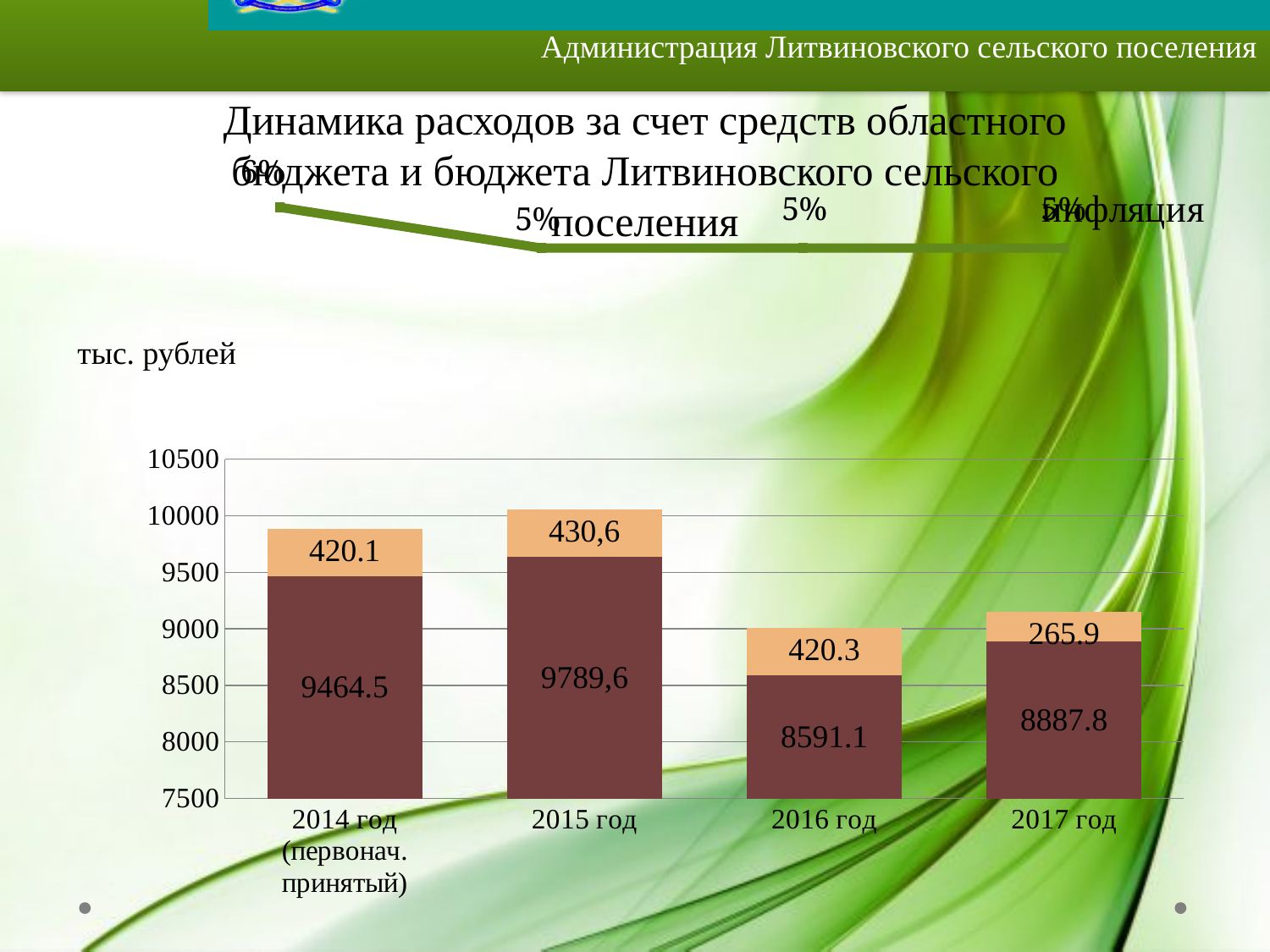
What is the value of the upper (orange) segment of the bar for 2017 год? 265.9 What is the total of the stacked bar for 2014 год (первонач. принятый)? 9884.6 What type of chart is used to show the expenditure values? bar chart What is the difference between the lower segment values for 2014 год (первонач. принятый) and 2016 год? 873.4 Which year has the lowest value in the lower (dark) segment? 2016 год What is the value of the upper (orange) segment of the bar for 2016 год? 420.3 How many years (categories) are shown on the x axis of the bar chart? 4 Which is larger: the upper segment for 2015 год or the upper segment for 2017 год? 2015 год What is the value of the lower (dark) segment of the bar for 2015 год? 9789,6 Which year has the highest value in the lower (dark) segment? 2015 год Which year has the smallest upper (orange) segment? 2017 год Is the lower segment value for 2017 год greater or less than 9000? less